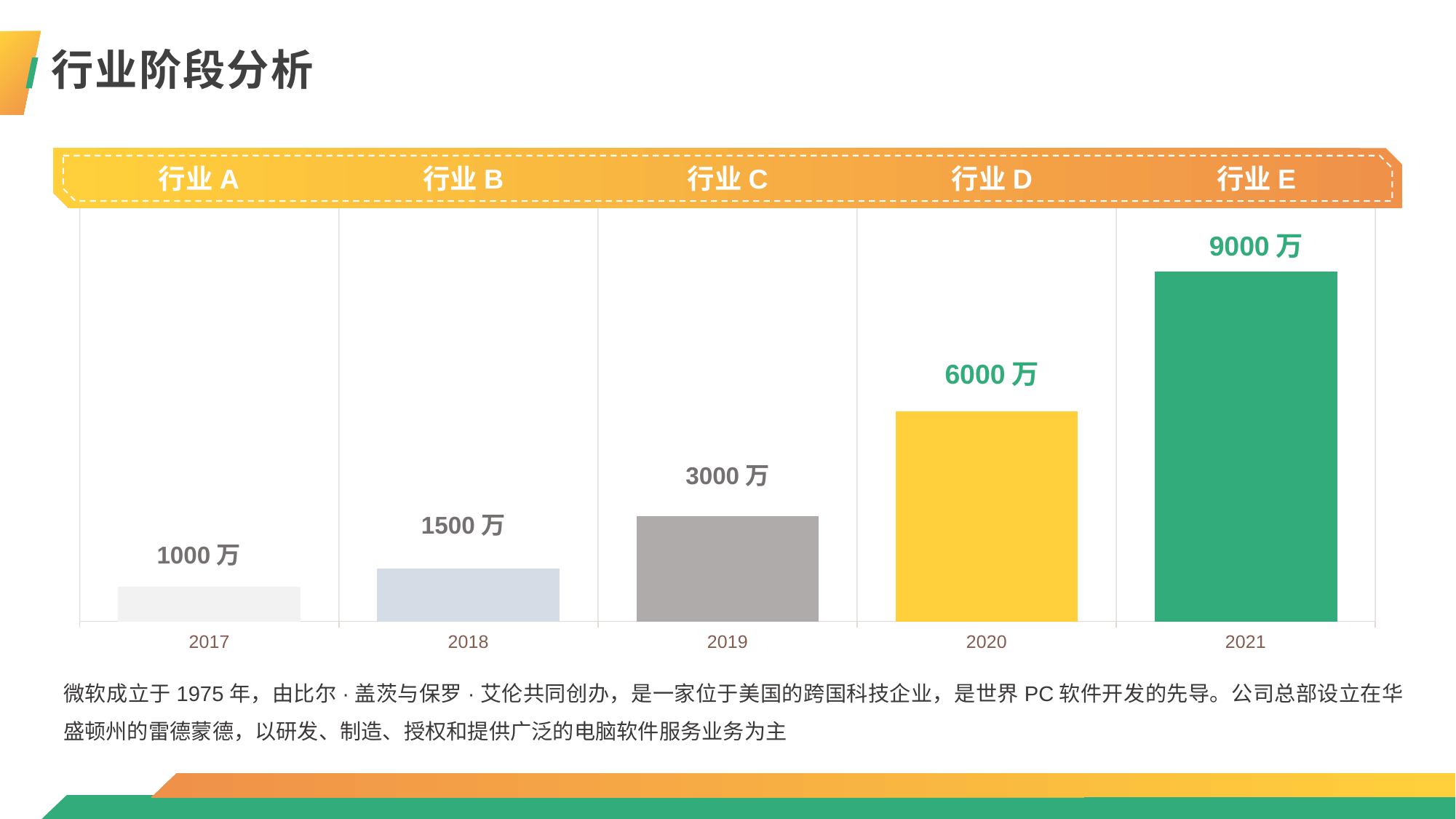
What is the value for 2021? 9000 万 Which year has the highest value? 2021 Which year has the lowest value? 2017 What is the value for 2019? 3000 万 Which is larger, the value for 2018 or the value for 2020? 2020 What is the difference between the values for 2021 and 2017? 8000 万 What is the value for 2017? 1000 万 What is the difference between the values for 2020 and 2019? 3000 万 What kind of chart is shown on the slide? bar chart Do the values rise or fall from 2017 to 2021? rise How many bars are plotted in the chart? 5 What is the title of the slide containing the chart? 行业阶段分析